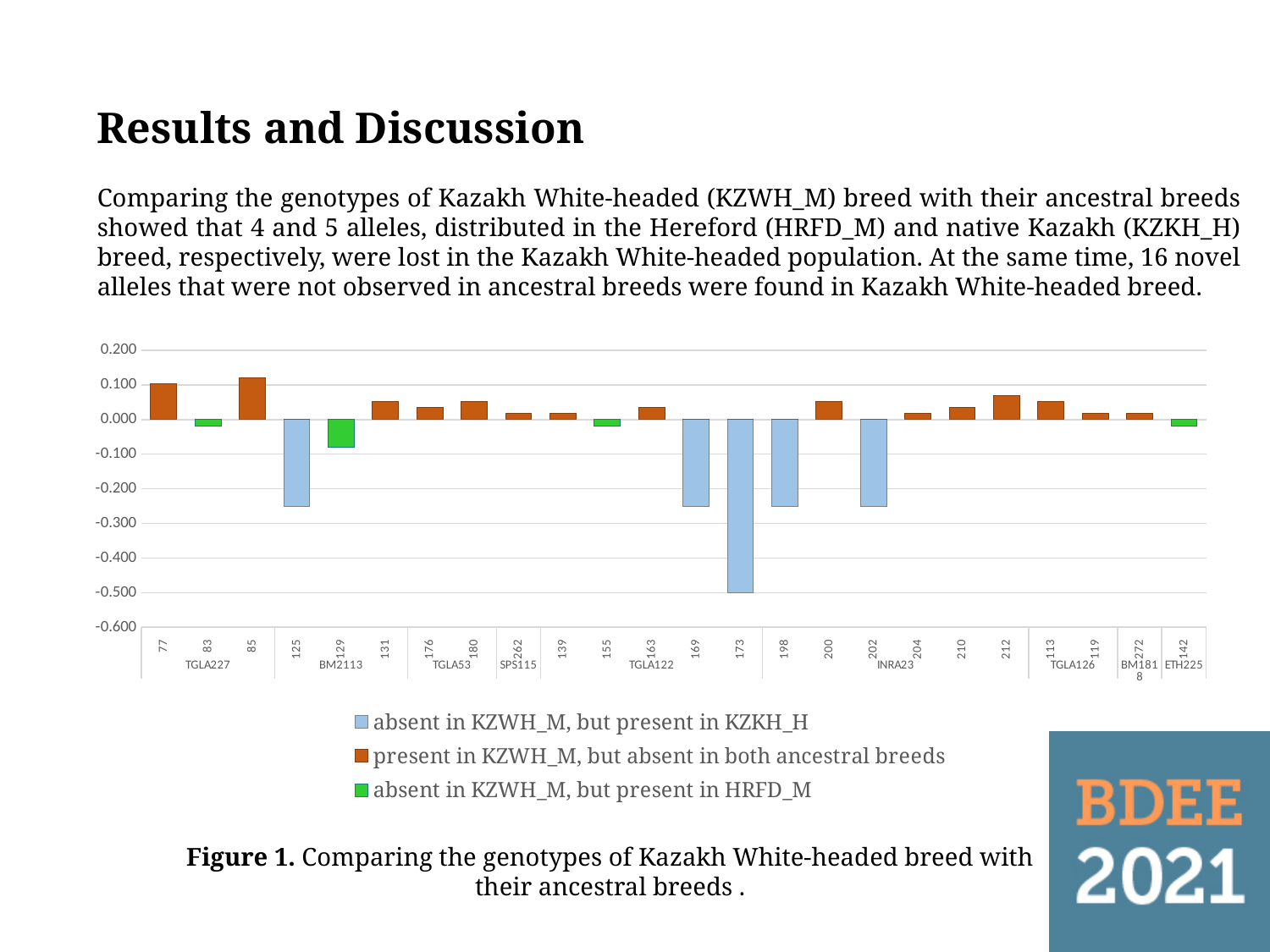
Which has the larger value, allele 77 or allele 83? 77 How many allele categories are plotted along the x axis? 24 How many series does the legend list? 3 Is the value for allele 129 greater or less than -0.100? greater Which legend entry is shown in light blue? absent in KZWH_M, but present in KZKH_H Is the value for allele 173 greater or less than -0.400? less What kind of chart is shown on the slide? bar chart Which legend entry is shown in green? absent in KZWH_M, but present in HRFD_M Is the value for allele 77 greater or less than 0.000? greater Which allele has the highest value in the chart? 85 Which allele has the lowest (most negative) value in the chart? 173